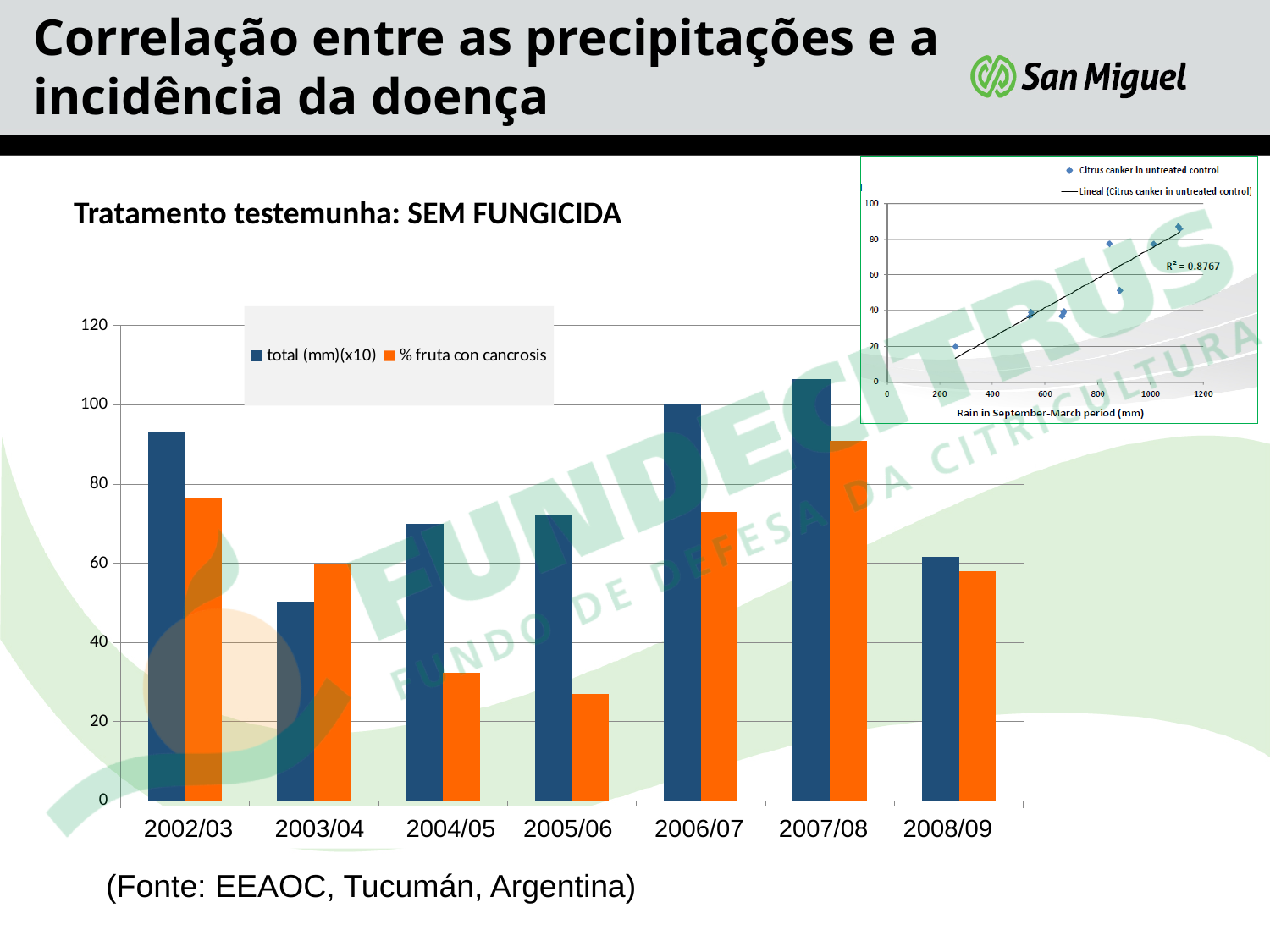
In the large bar chart, for 2003/04, which is larger: total (mm)(x10) or % fruta con cancrosis? % fruta con cancrosis In the large bar chart, is the value for total (mm)(x10) in 2002/03 greater or less than 80? greater In the large bar chart, is the value for % fruta con cancrosis in 2007/08 greater or less than 80? greater In the large bar chart, which season has the highest value for total (mm)(x10)? 2007/08 In the inset scatter chart at the top right, what R² value is shown? R² = 0.8767 In the large bar chart, is the value for % fruta con cancrosis in 2005/06 greater or less than 40? less In the large bar chart, which season has the lowest value for total (mm)(x10)? 2003/04 In the large bar chart, how many series does the legend list? 2 What kind of chart is the large chart on the slide? bar chart In the large bar chart, how many seasons are shown on the x axis? 7 In the large bar chart, which is larger: total (mm)(x10) in 2006/07 or in 2008/09? 2006/07 In the large bar chart, which season has the highest value for % fruta con cancrosis? 2007/08